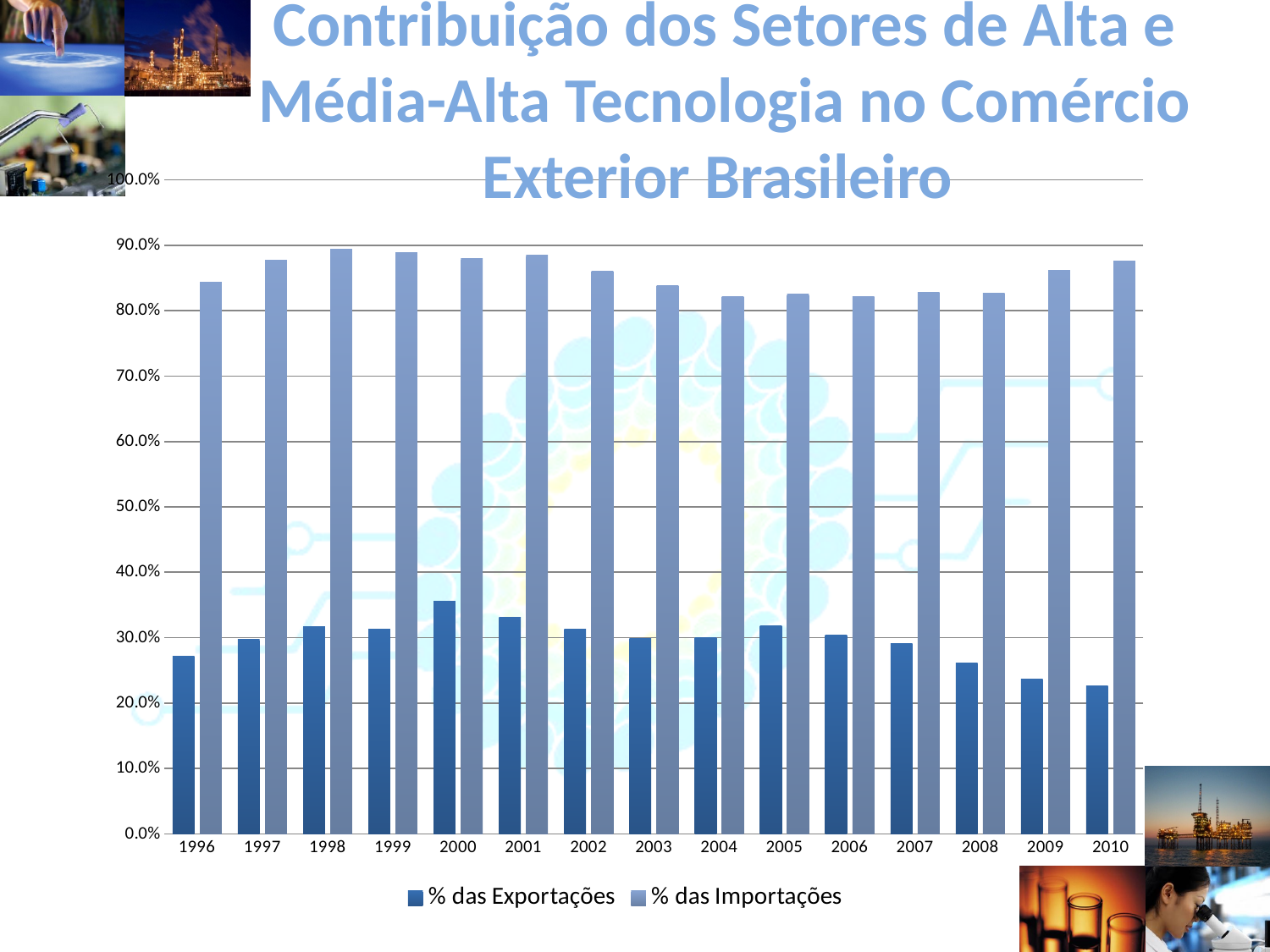
What are the two series named in the legend? % das Exportações and % das Importações Is the value for % das Importações in 2004 greater or less than 90.0%? less Is the value for % das Exportações in 2000 greater or less than 30.0%? greater Which is larger, the % das Exportações value for 2000 or for 2010? 2000 Do the % das Exportações values rise or fall from 2005 to 2010? fall In which year is the value for % das Exportações highest? 2000 How many years are shown on the x axis of the chart? 15 Which is larger, the % das Importações value for 1998 or for 2004? 1998 Is the value for % das Exportações in 2010 greater or less than 30.0%? less What kind of chart is shown on the slide? bar chart How many series does the chart's legend list? 2